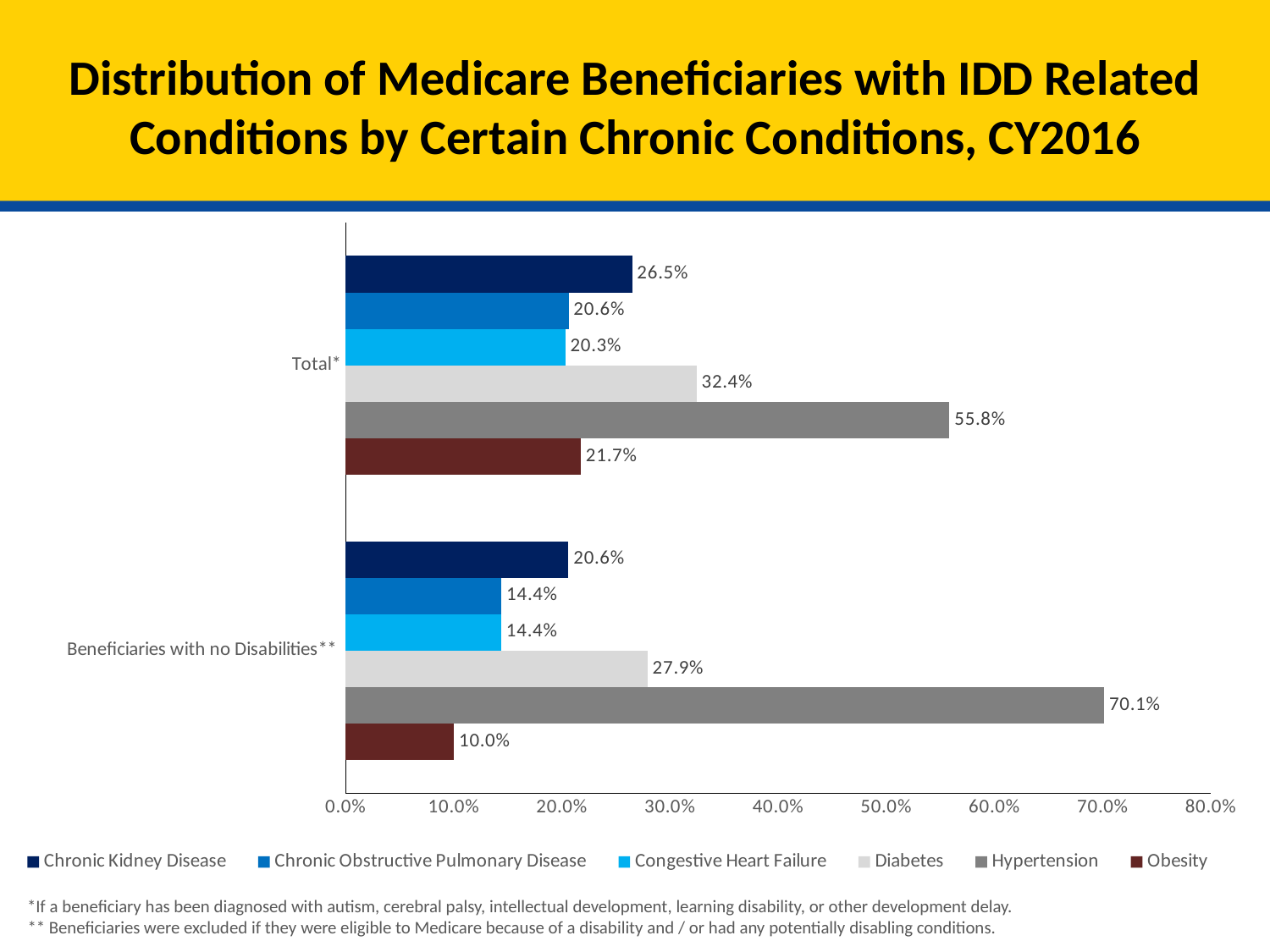
Which chronic condition has the lowest value for the Total* group? Congestive Heart Failure What is the Hypertension value for the Total* group? 55.8% Is the Diabetes value for Beneficiaries with no Disabilities** greater or less than 30.0%? less How many groups (categories) are shown on the vertical axis? 2 What is the Obesity value for Beneficiaries with no Disabilities**? 10.0% What kind of chart is shown on the slide? Bar chart Which chronic condition has the highest value for Beneficiaries with no Disabilities**? Hypertension What is the maximum value shown on the horizontal axis? 80.0% Which is larger: the Chronic Kidney Disease value for Total* or for Beneficiaries with no Disabilities**? Total* What is the difference between the Hypertension values for Beneficiaries with no Disabilities** and Total*? 14.3% What is the Diabetes value for the Total* group? 32.4% How many series does the legend list? 6